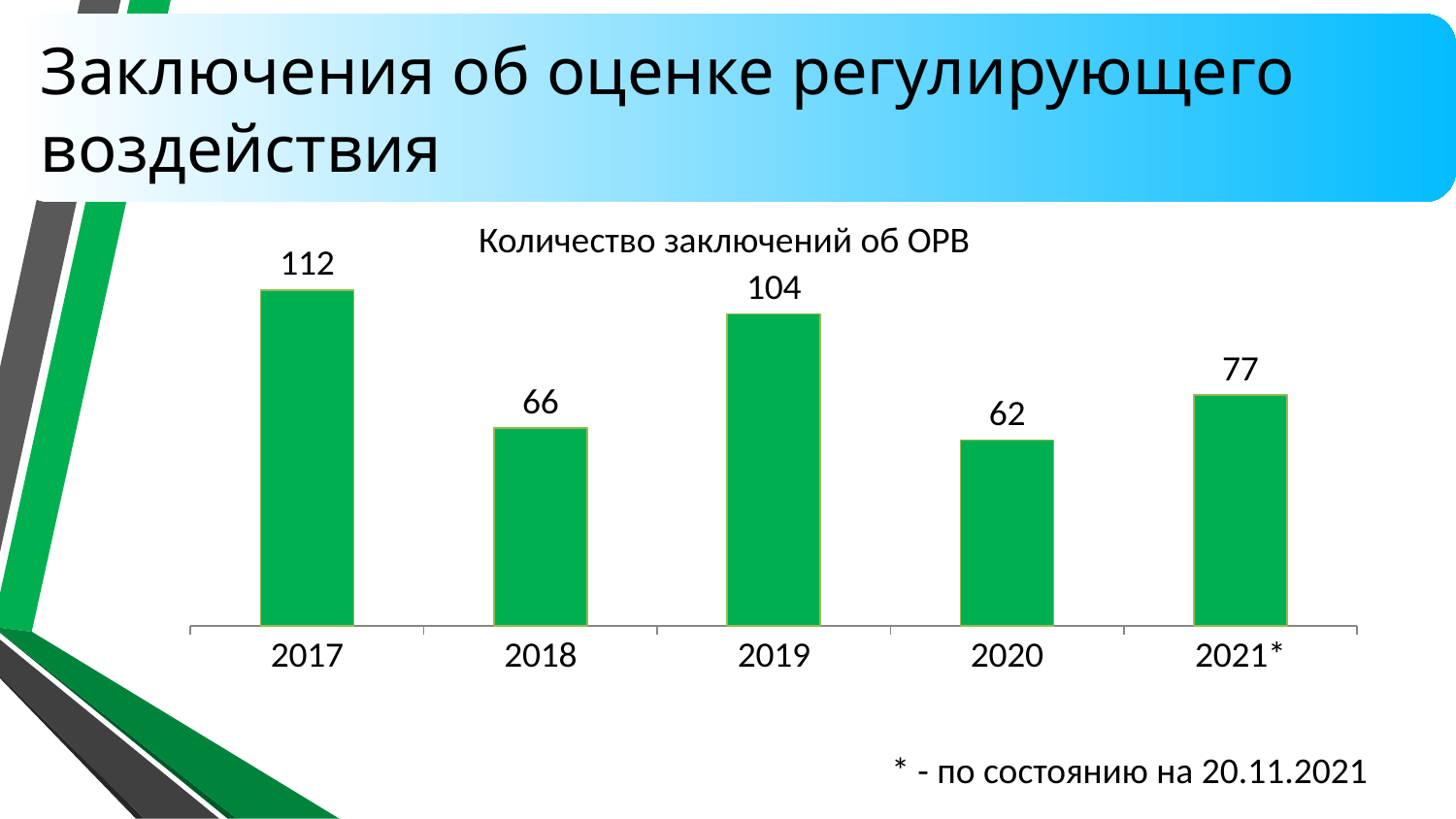
What kind of chart is this? bar chart What is the difference between the values for 2019 and 2020? 42 How many years are shown on the x axis? 5 What colour are the bars? green What is the value for 2021*? 77 Which year has the lowest value? 2020 What is the title of the chart? Количество заключений об ОРВ Which is larger, the value for 2018 or the value for 2021*? 2021* Which year has the highest value? 2017 What is the value for 2017? 112 What is the value for 2019? 104 What is the difference between the values for 2017 and 2018? 46